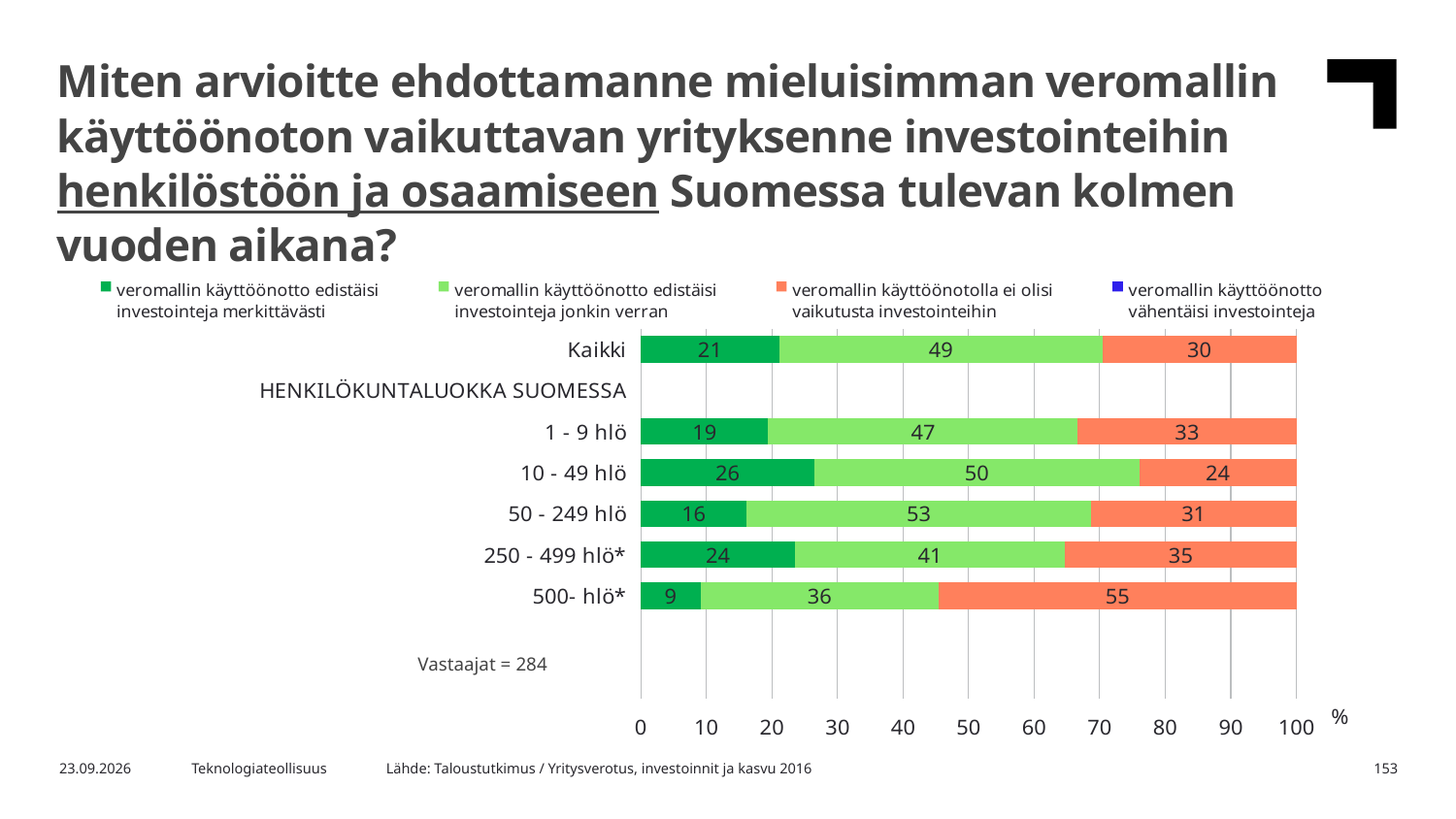
Which is larger: the 'edistäisi investointeja merkittävästi' value for 250 - 499 hlö* or for 1 - 9 hlö? 250 - 499 hlö* What is the value for 'veromallin käyttöönotto edistäisi investointeja merkittävästi' in the Kaikki bar? 21 How many respondents (Vastaajat) does the chart report? 284 What kind of chart is shown on the slide? stacked bar chart What is the total of the stacked bar for 1 - 9 hlö? 99 What is the value for 'veromallin käyttöönotolla ei olisi vaikutusta investointeihin' in the 500- hlö* bar? 55 How many company size categories (excluding Kaikki) are plotted? 5 Which category has the lowest value for 'veromallin käyttöönotto edistäisi investointeja jonkin verran'? 500- hlö* Which category has the highest value for 'veromallin käyttöönotto edistäisi investointeja merkittävästi'? 10 - 49 hlö What is the value for 'veromallin käyttöönotto edistäisi investointeja jonkin verran' in the 50 - 249 hlö bar? 53 What is the difference between the 'ei olisi vaikutusta' values for 500- hlö* and 10 - 49 hlö? 31 How many series does the legend list? 4